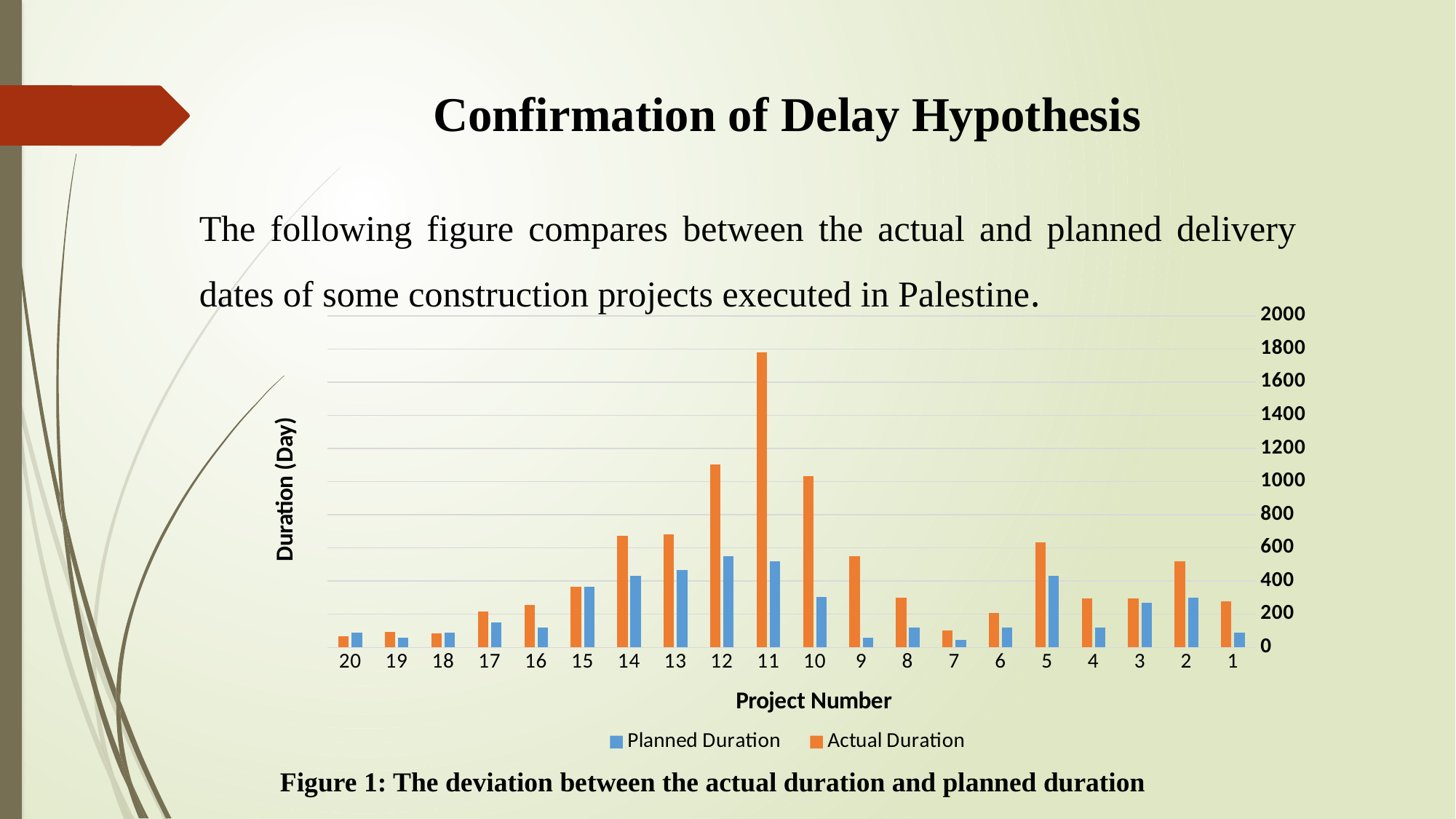
Which is larger, the Planned Duration for project 5 or the Planned Duration for project 4? project 5 Is the Actual Duration for project 12 greater or less than 1000? greater Which is larger, the Actual Duration for project 11 or the Actual Duration for project 12? project 11 What kind of chart is shown on the slide? bar chart Which project number has the highest Actual Duration? 11 Is the Planned Duration for project 12 greater or less than 400? greater How many series does the chart legend list? 2 Is the Actual Duration for project 7 greater or less than 200? less How many project numbers are shown on the x axis of the chart? 20 What is the title of the y axis of the chart? Duration (Day)